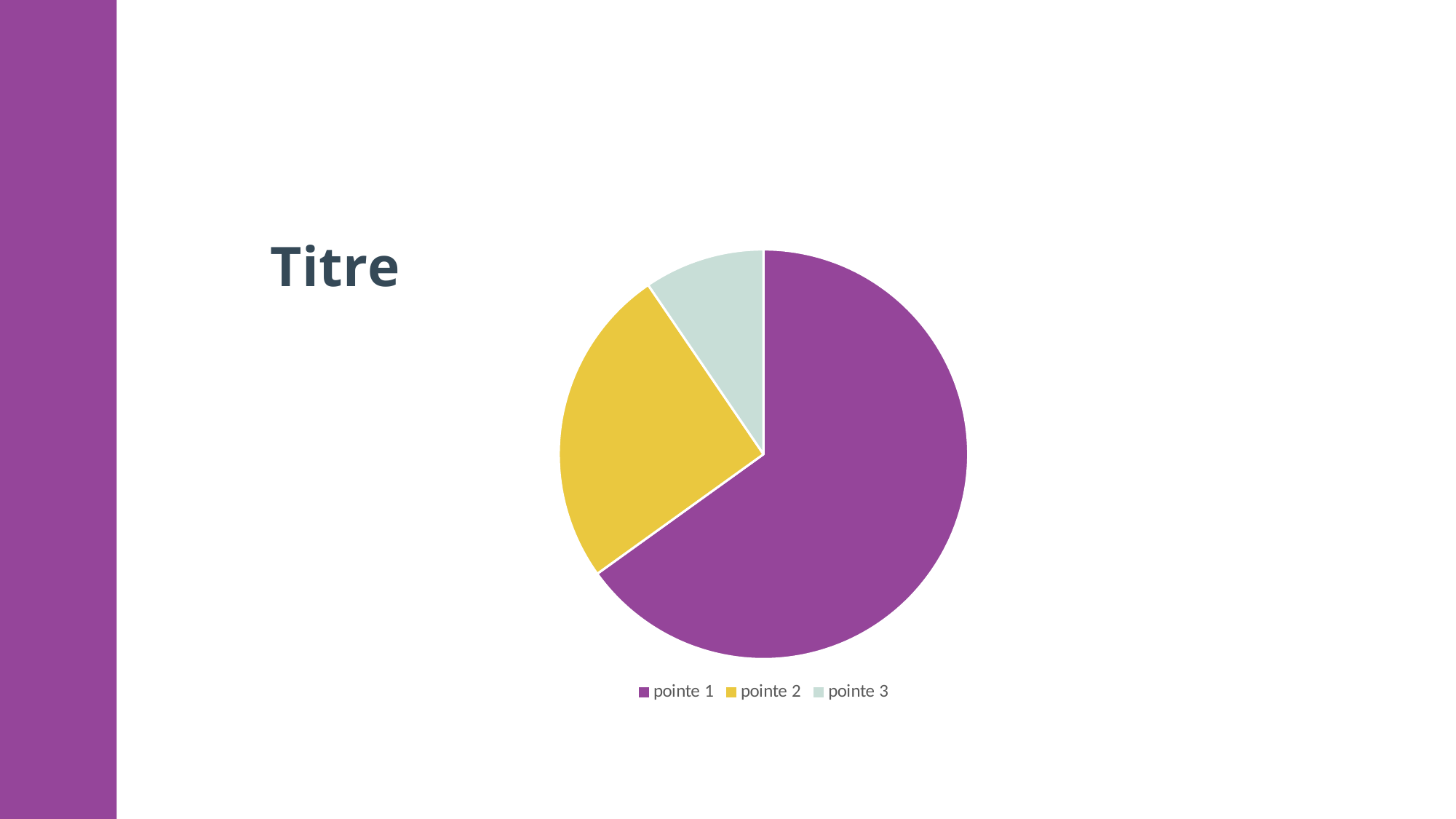
What colour is the slice for pointe 1? purple Which is larger, the slice for pointe 1 or the slice for pointe 2? pointe 1 Which slice is the smallest in the pie chart? pointe 3 Which is larger, the slice for pointe 2 or the slice for pointe 3? pointe 2 What kind of chart is shown on the slide? pie chart What colour is the slice for pointe 2? yellow How many entries does the legend list? 3 How many slices does the pie chart have? 3 Which slice is the largest in the pie chart? pointe 1